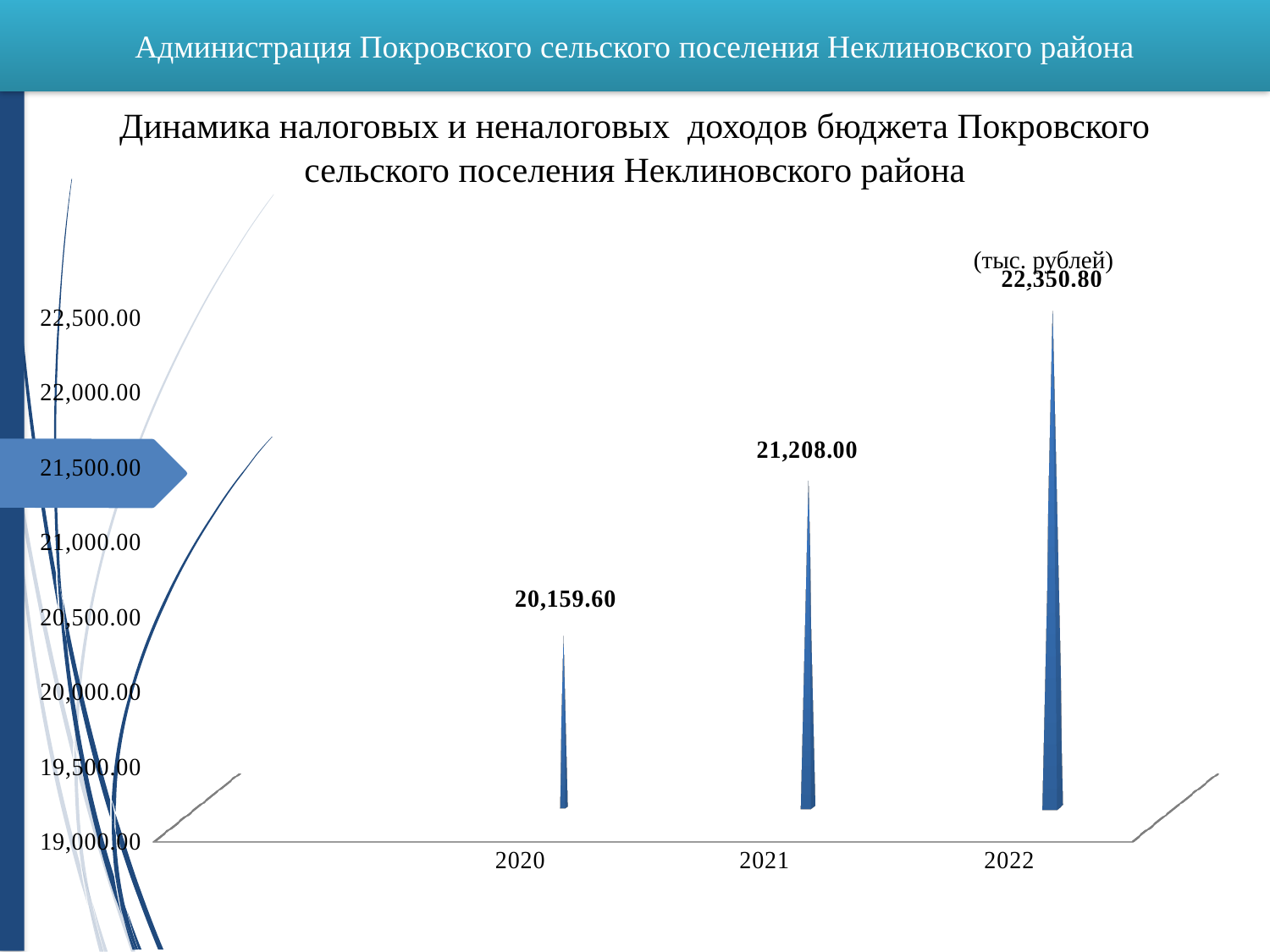
In what units are the values on the chart expressed? тыс. рублей Which is larger, the value for 2021 or the value for 2020? 2021 Which year has the lowest value? 2020 What is the value shown for 2021? 21,208.00 What is the difference between the values for 2022 and 2021? 1,142.80 What is the value shown for 2020? 20,159.60 What is the difference between the values for 2021 and 2020? 1,048.40 Which year has the highest value? 2022 Is the value for 2021 greater or less than 21,500.00? less What is the value shown for 2022? 22,350.80 How many years are shown on the x axis? 3 Do the values rise or fall from 2020 to 2022? rise